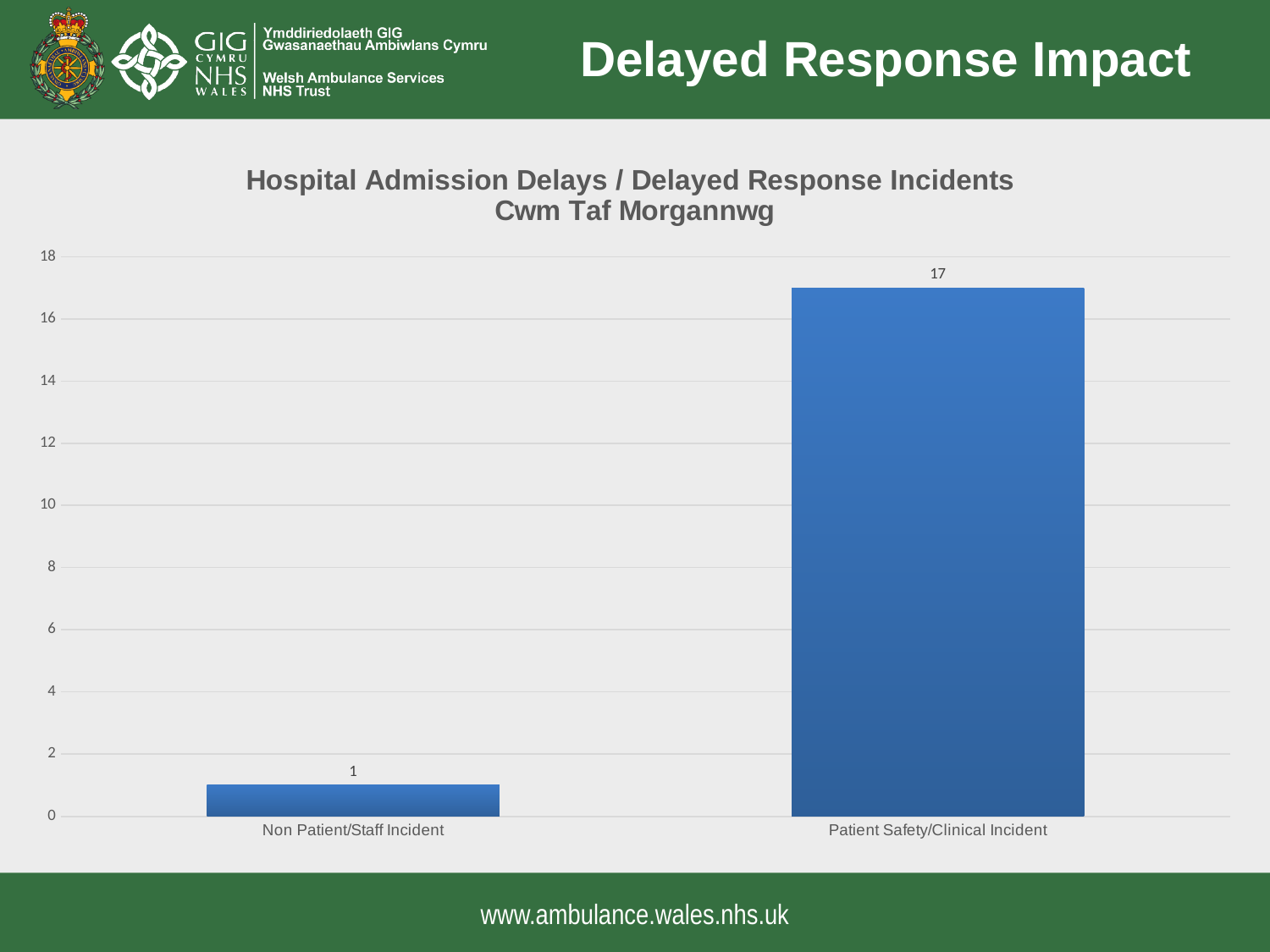
What is the value for Non Patient/Staff Incident? 1 Which category has the lowest value? Non Patient/Staff Incident What is the total of the two values shown on the chart? 18 How many categories are shown on the chart? 2 What is the value for Patient Safety/Clinical Incident? 17 Is the value for Non Patient/Staff Incident greater or less than 2? less Is the value for Patient Safety/Clinical Incident greater or less than 10? greater What kind of chart is shown on the slide? Bar chart Which is larger: the value for Non Patient/Staff Incident or the value for Patient Safety/Clinical Incident? Patient Safety/Clinical Incident Which category has the highest value? Patient Safety/Clinical Incident What is the title of the chart? Hospital Admission Delays / Delayed Response Incidents Cwm Taf Morgannwg What is the difference between the values for Patient Safety/Clinical Incident and Non Patient/Staff Incident? 16